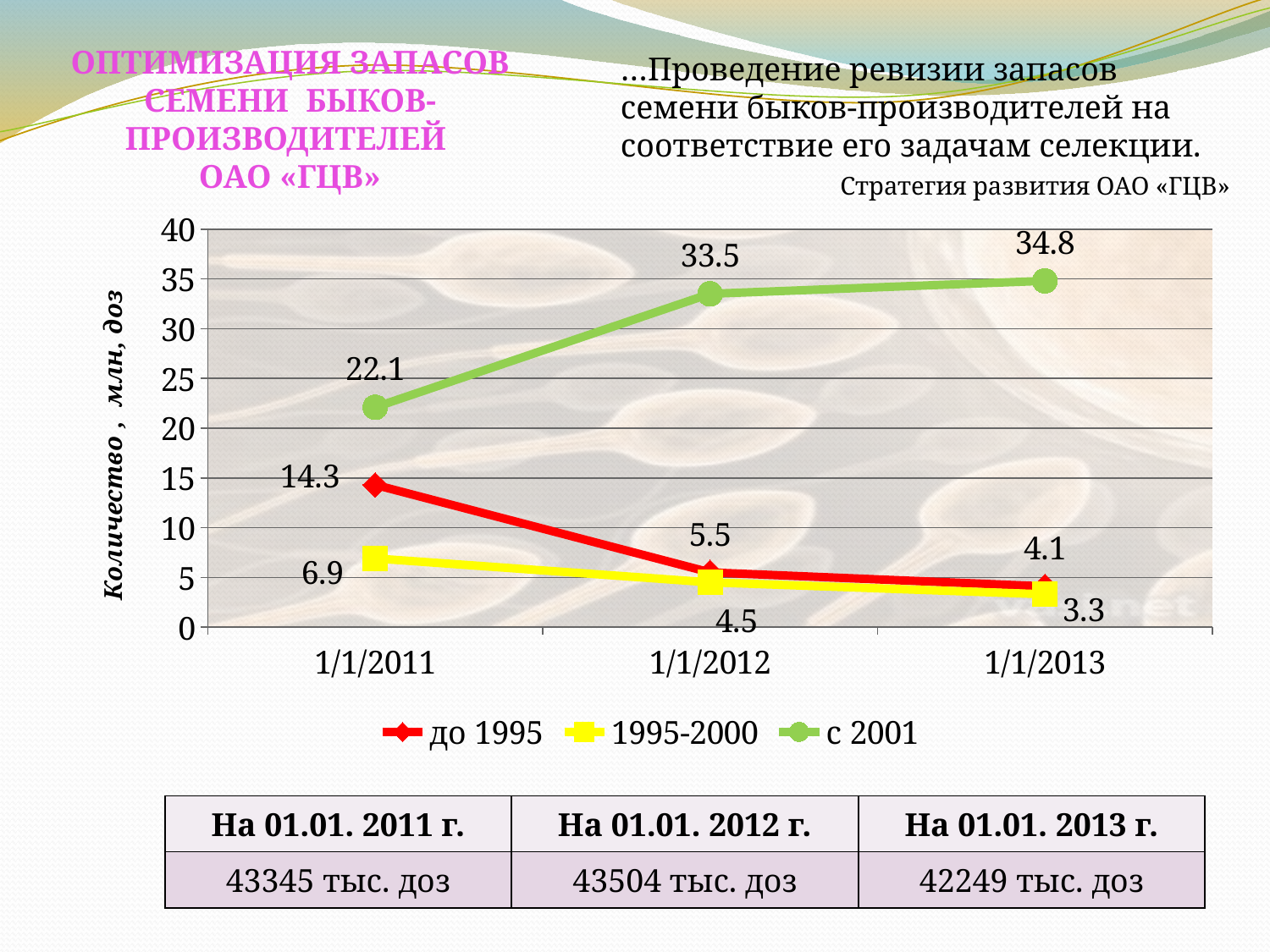
At which date is the 'до 1995' series lowest? 1/1/2013 Does the 'до 1995' series rise or fall from 1/1/2011 to 1/1/2013? fall How many dates are plotted on the x axis of the chart? 3 Which is larger at 1/1/2012: the 'до 1995' value or the '1995-2000' value? до 1995 What type of chart is shown on the slide? line chart At which date does the 'с 2001' series reach its highest value? 1/1/2013 What is the difference between the 'с 2001' value at 1/1/2013 and at 1/1/2011? 12.7 What is the value of the '1995-2000' series at 1/1/2013? 3.3 What is the value of the 'с 2001' series at 1/1/2012? 33.5 What is the value of the 'до 1995' series at 1/1/2011? 14.3 What is the label of the chart's vertical axis? Количество , млн, доз How many series does the chart legend list? 3